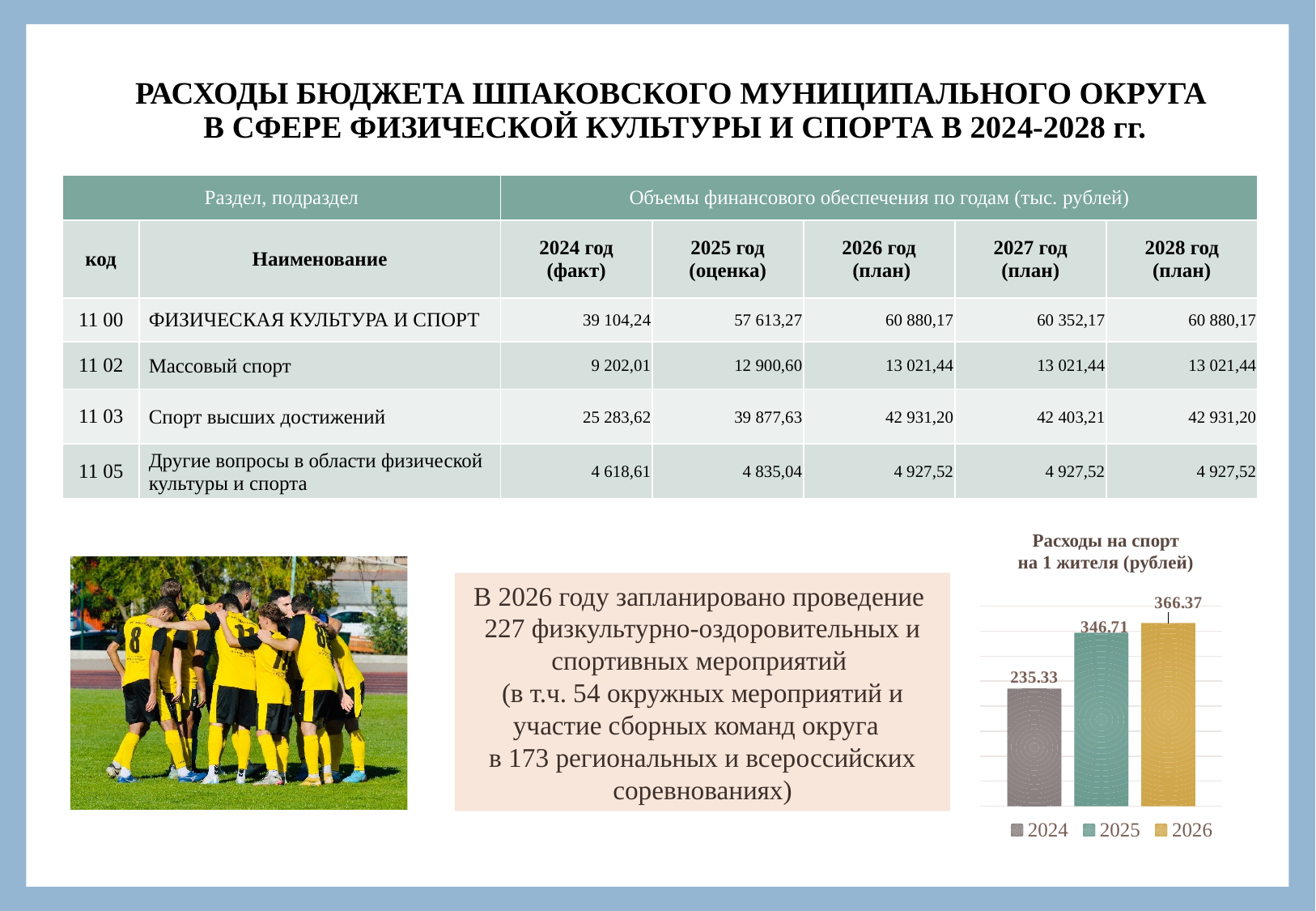
What type of chart is "Расходы на спорт на 1 жителя (рублей)"? Bar chart How many bars are shown in the chart "Расходы на спорт на 1 жителя (рублей)"? 3 In the chart "Расходы на спорт на 1 жителя (рублей)", which is larger: the value for 2024 or the value for 2025? 2025 What is the value for 2024 in the chart "Расходы на спорт на 1 жителя (рублей)"? 235.33 Which year has the highest value in the chart "Расходы на спорт на 1 жителя (рублей)"? 2026 In the chart "Расходы на спорт на 1 жителя (рублей)", what is the difference between the 2026 and 2025 values? 19.66 In the chart "Расходы на спорт на 1 жителя (рублей)", what is the difference between the 2026 and 2024 values? 131.04 Which year has the lowest value in the chart "Расходы на спорт на 1 жителя (рублей)"? 2024 In the chart "Расходы на спорт на 1 жителя (рублей)", what is the difference between the 2025 and 2024 values? 111.38 What is the value for 2025 in the chart "Расходы на спорт на 1 жителя (рублей)"? 346.71 What is the value for 2026 in the chart "Расходы на спорт на 1 жителя (рублей)"? 366.37 How many entries does the legend of the chart "Расходы на спорт на 1 жителя (рублей)" list? 3